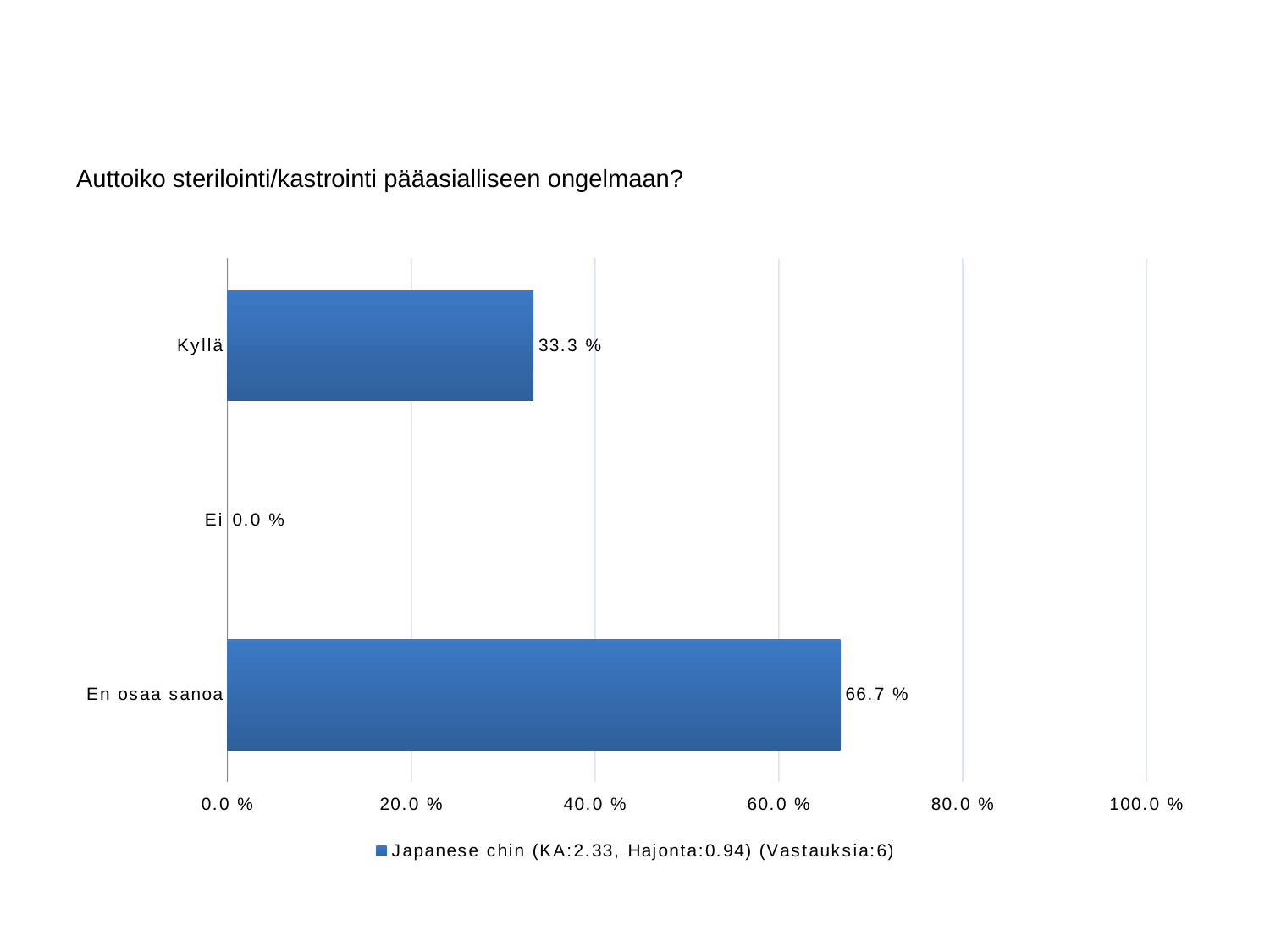
How many categories are shown in the chart? 3 What is the title of the chart? Auttoiko sterilointi/kastrointi pääasialliseen ongelmaan? What is the value for En osaa sanoa? 66.7 % How many series does the legend list? 1 What is the value for Ei? 0.0 % Which category has the lowest value? Ei Which category has the highest value? En osaa sanoa What kind of chart is shown on the slide? bar chart Which is larger, the value for Kyllä or the value for En osaa sanoa? En osaa sanoa What is the value for Kyllä? 33.3 % Is the value for En osaa sanoa greater or less than 60.0 %? greater What is the difference between the values for En osaa sanoa and Kyllä? 33.4 %